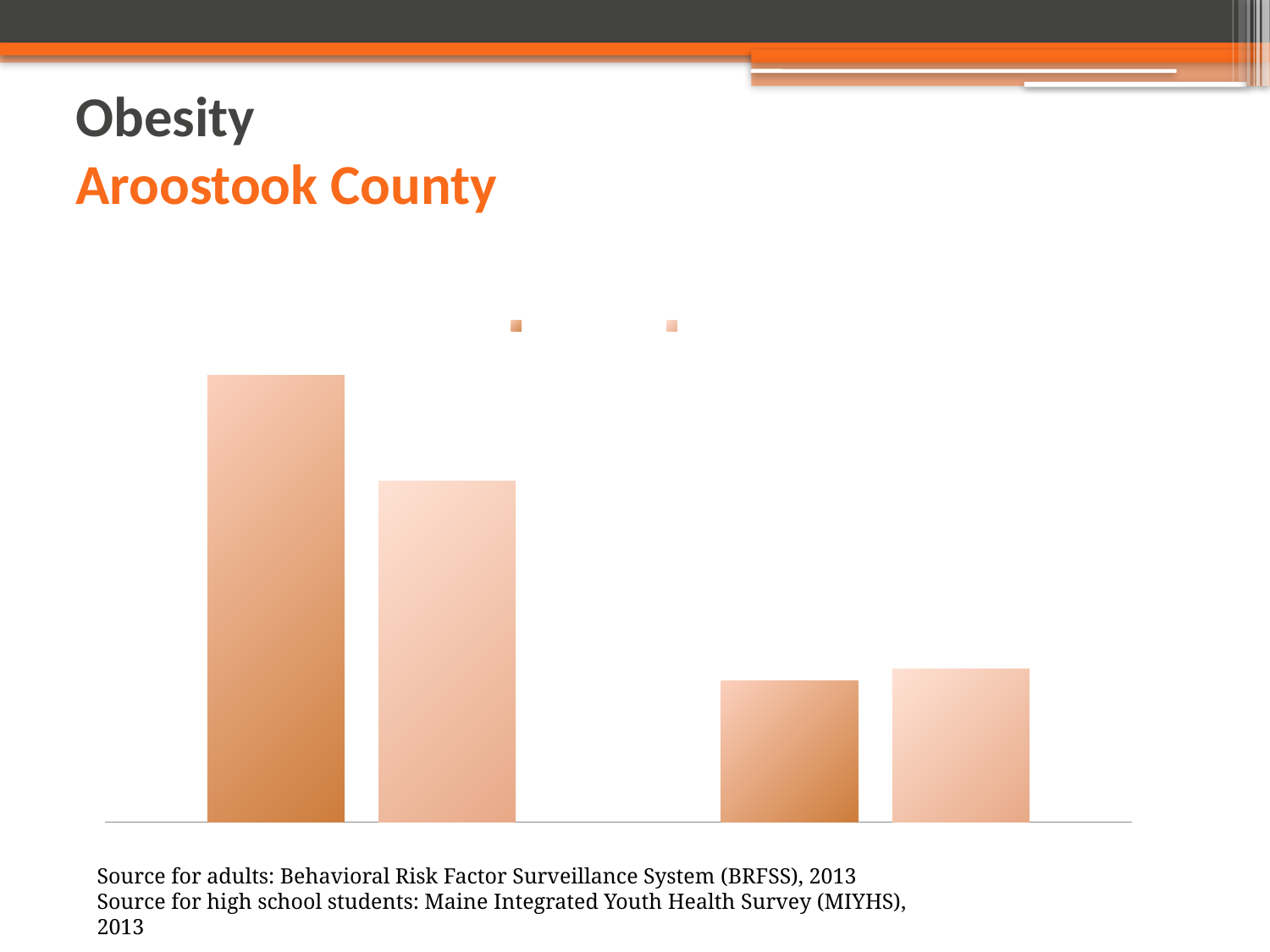
How many bars are plotted in the chart? 4 Into how many groups are the bars arranged in the chart? 2 What colour are the bars in the chart? orange Which bar is the shortest in the chart? the third bar from the left Is the rightmost bar taller or shorter than the third bar from the left? taller Which bar is the tallest in the chart? the leftmost bar What kind of chart is shown on the slide? bar chart What county does the slide title say the obesity chart is about? Aroostook County How many series does the chart's legend list? 2 Is the leftmost bar taller or shorter than the second bar from the left? taller